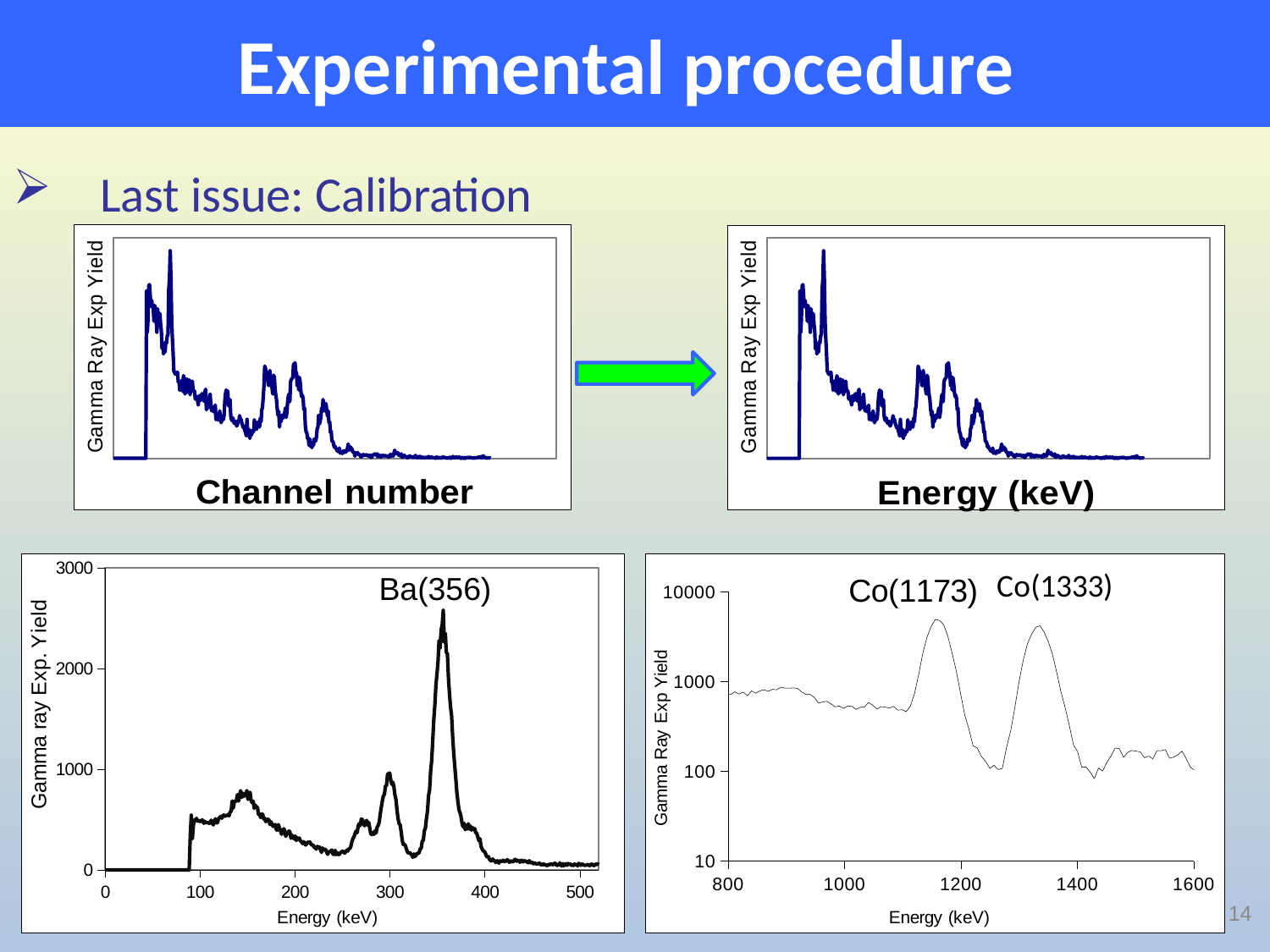
In the bottom-left chart, what is the label on the tallest peak? Ba(356) In the bottom-right chart, what are the labels of the two peaks? Co(1173) and Co(1333) In the bottom-left chart, is the value at 150 keV greater or less than 1000? less What kind of chart is the bottom-left chart with the Ba(356) peak? line chart In the bottom-right chart, is the value at the Co(1173) peak greater or less than 1000? greater What is the x-axis title of the top-right chart? Energy (keV) In the bottom-left chart, is the value at the Ba(356) peak greater or less than 2000? greater What is the x-axis title of the top-left chart? Channel number In the bottom-left chart, do the values rise or fall between 356 keV and 500 keV? fall In the bottom-left chart, which labeled peak has the highest yield? Ba(356) How many charts are shown on the slide? 4